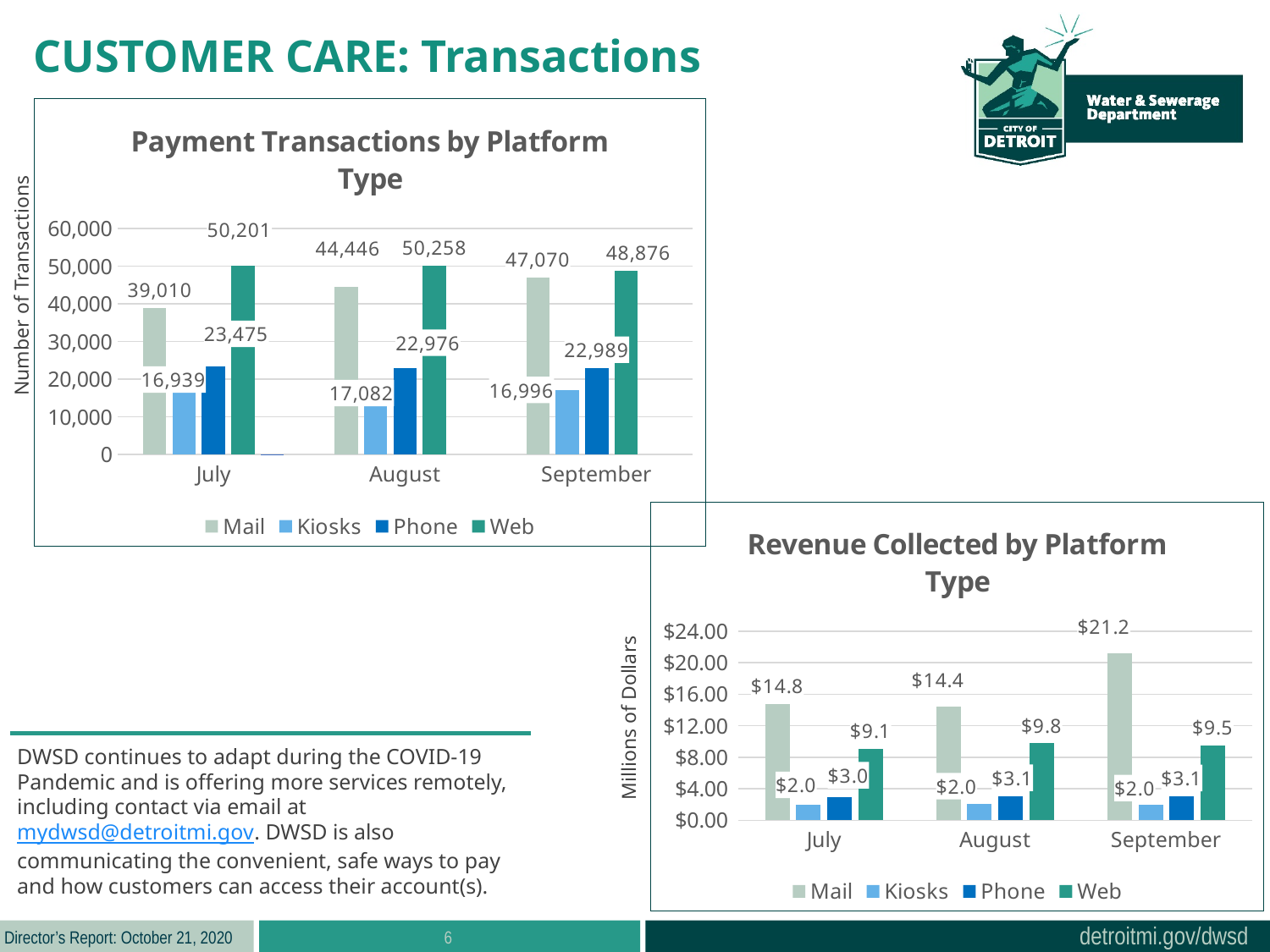
In the Payment Transactions by Platform Type chart, which month had the lowest number of Kiosks transactions? July In the Payment Transactions by Platform Type chart, how many Web transactions were there in July? 50,201 In the Revenue Collected by Platform Type chart, how much more Web revenue was collected in August than in July? $0.7 In the Payment Transactions by Platform Type chart, how many Kiosks transactions were there in August? 17,082 In the Revenue Collected by Platform Type chart, how much revenue was collected by Mail in September? $21.2 In the Payment Transactions by Platform Type chart, do Mail transactions rise or fall from July to September? Rise How many series does the legend of the Payment Transactions by Platform Type chart list? 4 What type of chart is the Revenue Collected by Platform Type chart? Bar chart How many months are shown on the x axis of the Revenue Collected by Platform Type chart? 3 In the Revenue Collected by Platform Type chart, which month had the highest Mail revenue? September In the Payment Transactions by Platform Type chart, which had more transactions in September, Mail or Web? Web In the Payment Transactions by Platform Type chart, what is the difference between Web transactions in August and September? 1,382